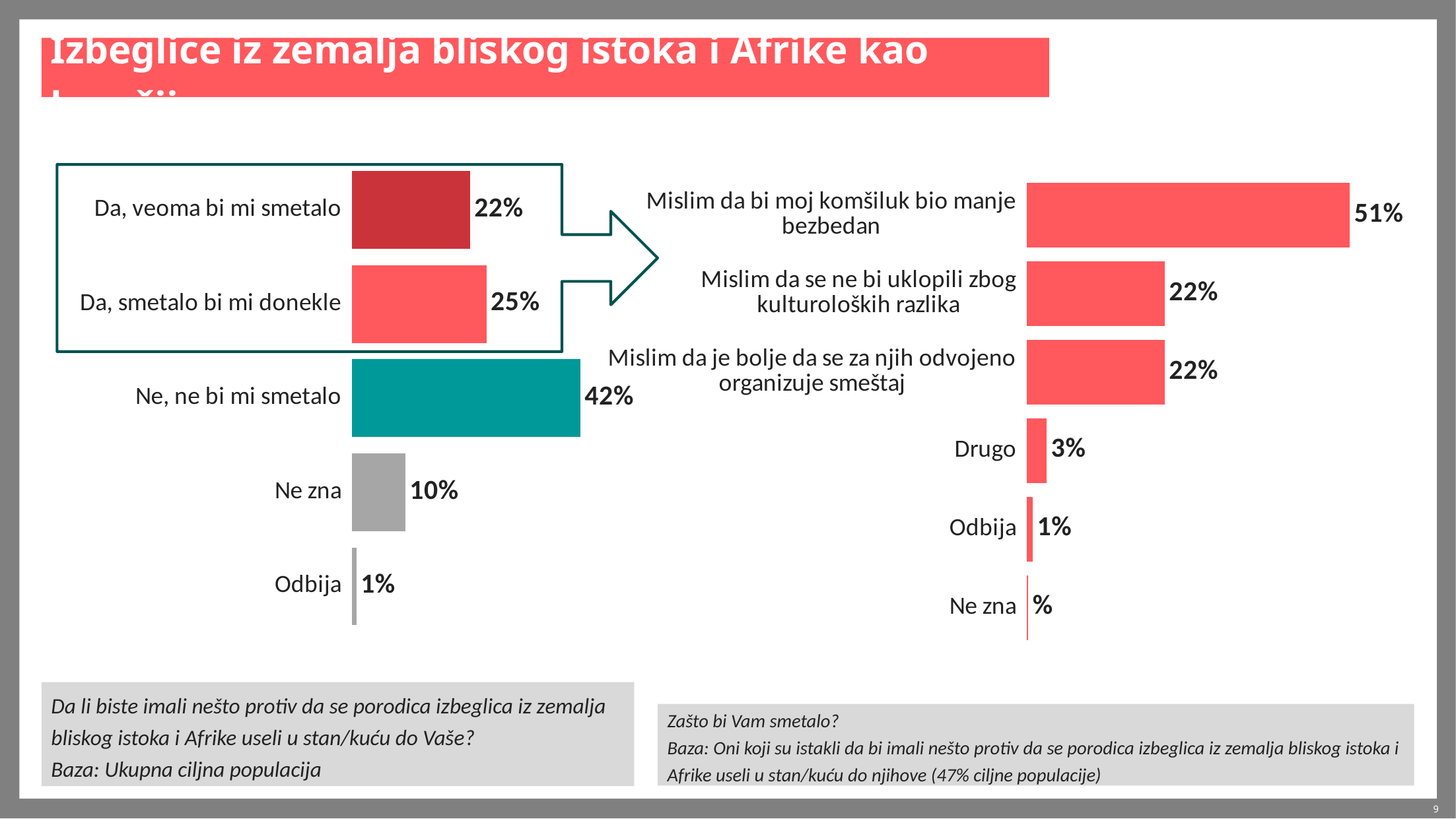
In the left chart, how many categories are shown? 5 In the left chart, what is the value for "Ne, ne bi mi smetalo"? 42% In the right chart, which category has the highest value? Mislim da bi moj komšiluk bio manje bezbedan In the right chart, what is the value for "Drugo"? 3% In the left chart, what is the difference between "Ne, ne bi mi smetalo" and "Da, veoma bi mi smetalo"? 20% In the right chart, which is larger: "Mislim da bi moj komšiluk bio manje bezbedan" or "Mislim da se ne bi uklopili zbog kulturoloških razlika"? Mislim da bi moj komšiluk bio manje bezbedan In the left chart, what is the value for "Da, smetalo bi mi donekle"? 25% What type of chart is the left chart? Bar chart In the left chart, which category has the highest value? Ne, ne bi mi smetalo In the right chart, what is the value for "Mislim da bi moj komšiluk bio manje bezbedan"? 51% In the left chart, which category has the lowest value? Odbija In the right chart, what is the difference between "Mislim da bi moj komšiluk bio manje bezbedan" and "Drugo"? 48%